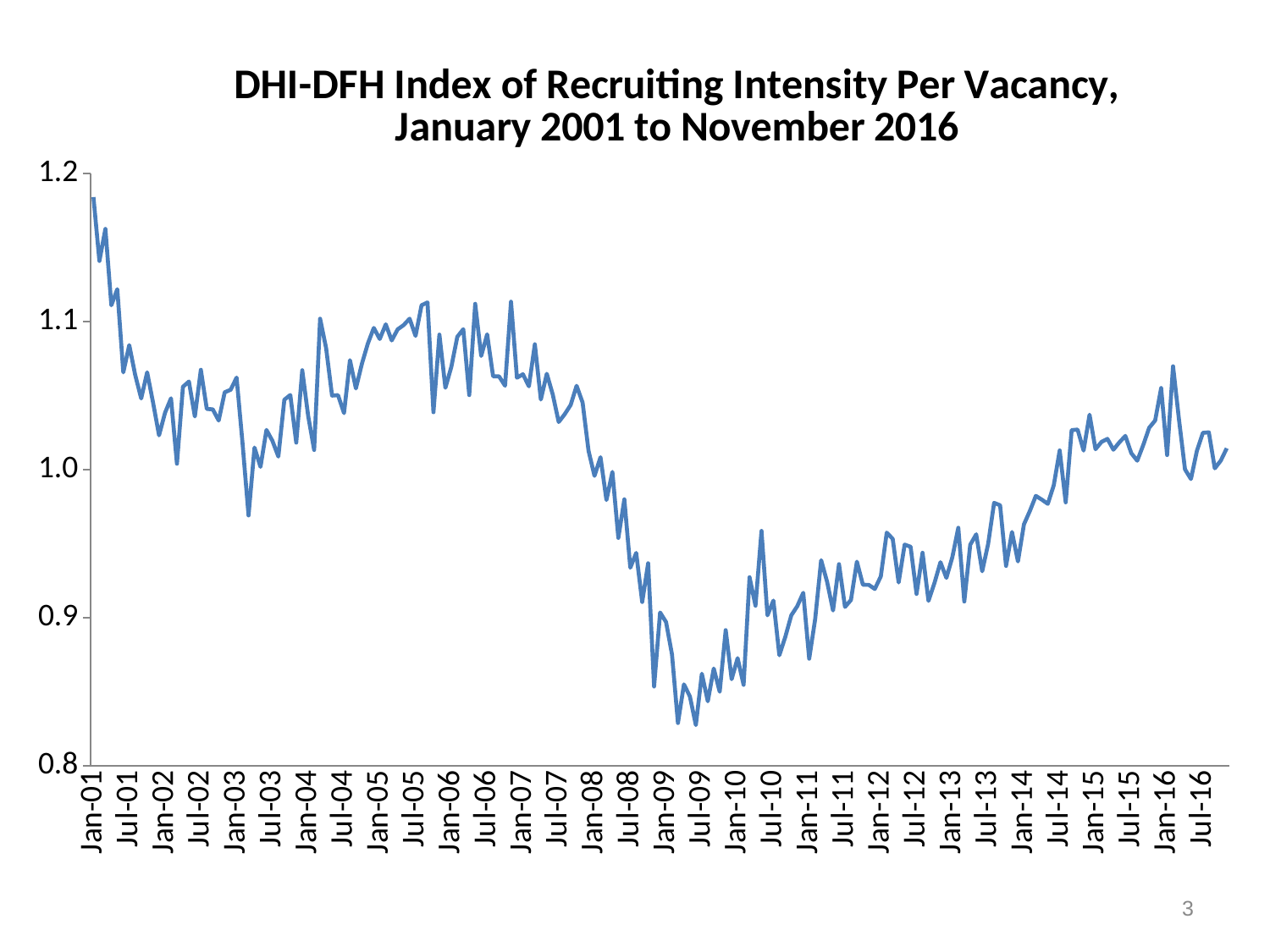
Near which x-axis label does the line reach its lowest value? Jul-09 Is the value for Jul-08 greater or less than 1.0? less Is the value for Jul-16 greater or less than 1.0? greater Does the index rise or fall between Jan-08 and Jul-09? fall What is the title of the chart? DHI-DFH Index of Recruiting Intensity Per Vacancy, January 2001 to November 2016 Does the index generally rise or fall between Jul-09 and Jan-16? rise Near which x-axis label does the line reach its highest value? Jan-01 Is the value for Jan-14 greater or less than 1.0? less What kind of chart is shown on the slide? line chart